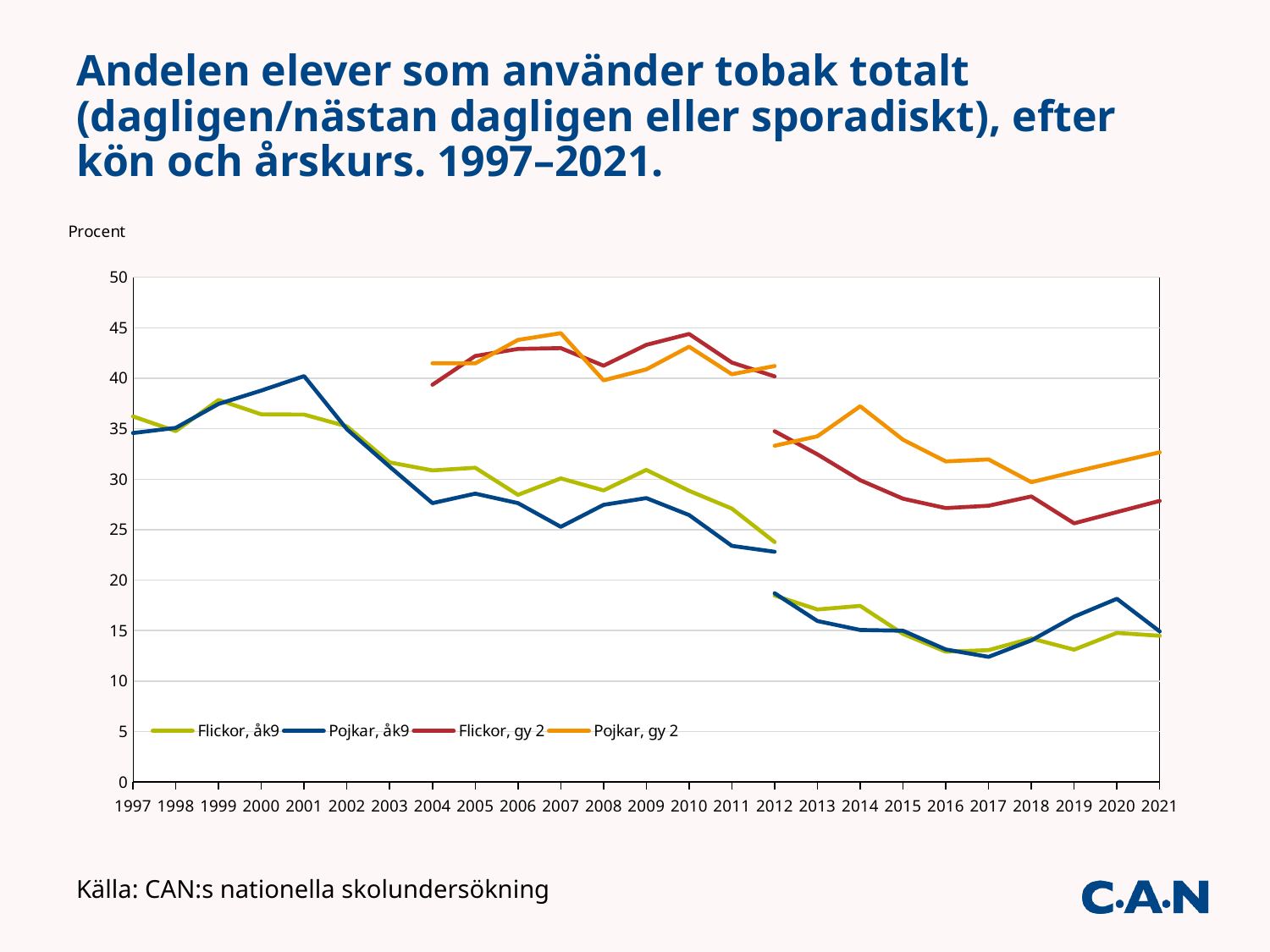
Is the value for Flickor, gy 2 in 2019 greater or less than 30? less Is the value for Pojkar, åk9 in 2017 greater or less than 15? less What is the label on the y axis? Procent Is the value for Pojkar, gy 2 in 2016 greater or less than 30? greater In 2014, which is larger: Pojkar, gy 2 or Flickor, gy 2? Pojkar, gy 2 How many series does the legend list? 4 Does the Pojkar, åk9 line rise or fall from 2001 to 2012? Fall How many years are shown on the x axis? 25 What kind of chart is shown on the slide? Line chart Which series has the highest value in 2021? Pojkar, gy 2